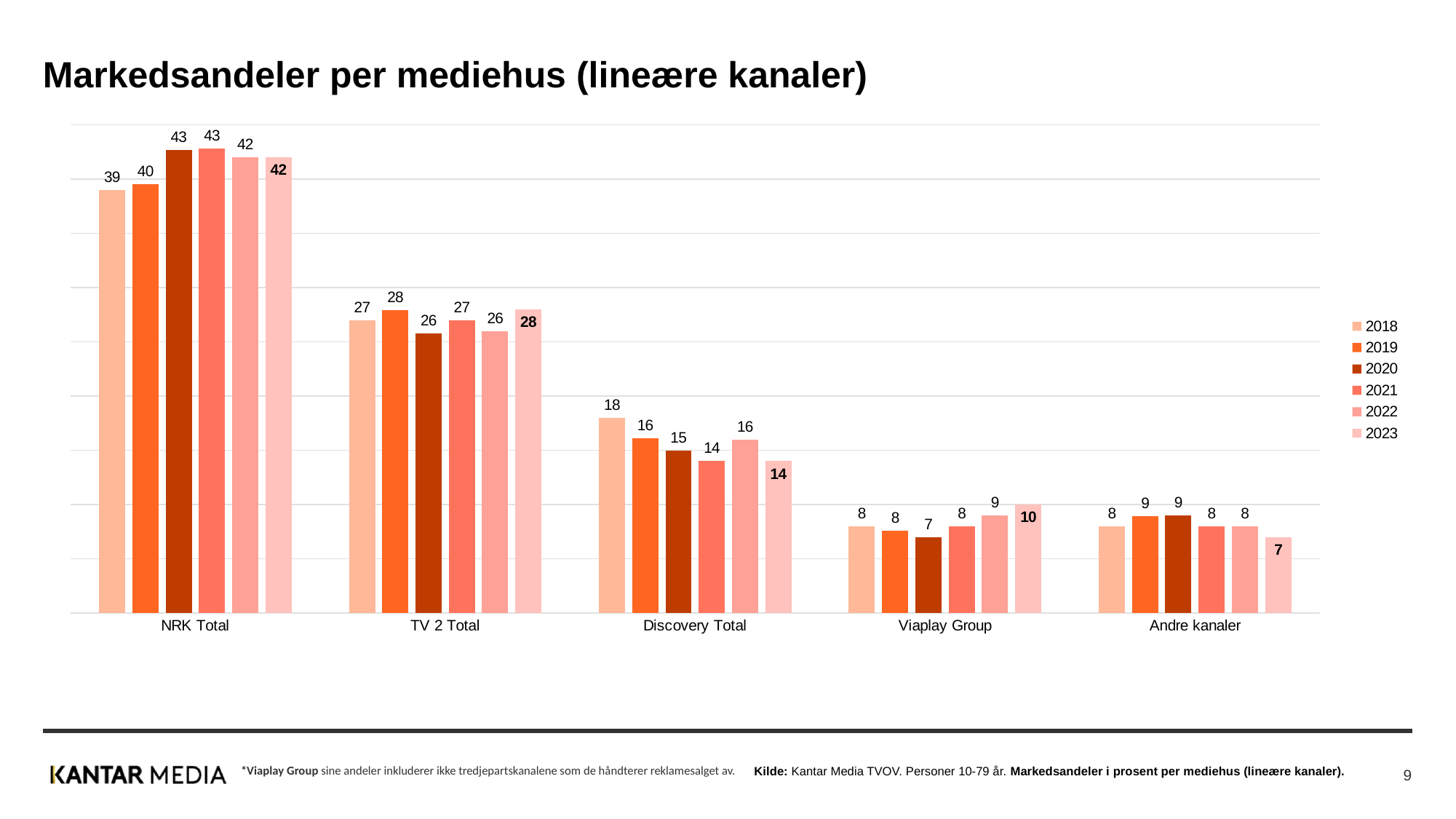
What is the value for NRK Total in 2023? 42 What is the difference between the 2018 and 2023 values for Discovery Total? 4 How many categories are shown on the x axis? 5 How many series does the legend list? 6 Which category has the lowest value in 2023? Andre kanaler What kind of chart is shown on the slide? Bar chart What is the title of the chart? Markedsandeler per mediehus (lineære kanaler) Which is larger for Viaplay Group: the 2020 value or the 2023 value? 2023 What is the value for Discovery Total in 2018? 18 Which category has the highest value in 2023? NRK Total What is the value for Viaplay Group in 2023? 10 What is the value for TV 2 Total in 2020? 26